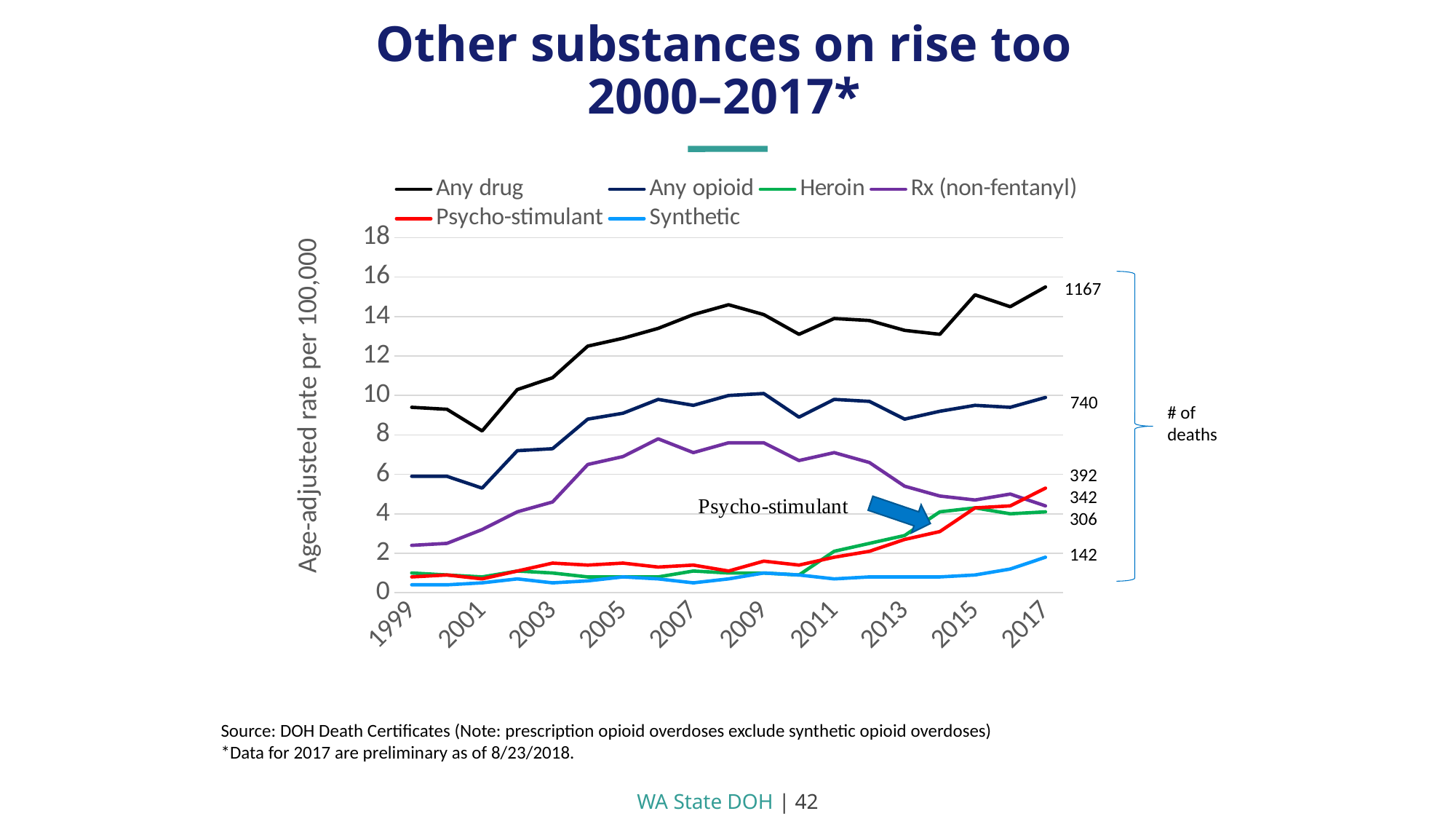
In 2017, which is higher: Psycho-stimulant or Heroin? Psycho-stimulant Is the value for Rx (non-fentanyl) in 2007 greater or less than 6? greater Which series has the highest value in 2017? Any drug What is the label on the y axis? Age-adjusted rate per 100,000 How many series does the legend list? 6 Does the Rx (non-fentanyl) line rise or fall from 2009 to 2017? fall In 2005, which is higher: Rx (non-fentanyl) or Heroin? Rx (non-fentanyl) Is the value for Any drug in 2017 greater or less than 14? greater Is the value for Synthetic in 2017 greater or less than 1? greater Which series has the lowest value in 2017? Synthetic What kind of chart is shown on the slide? line chart